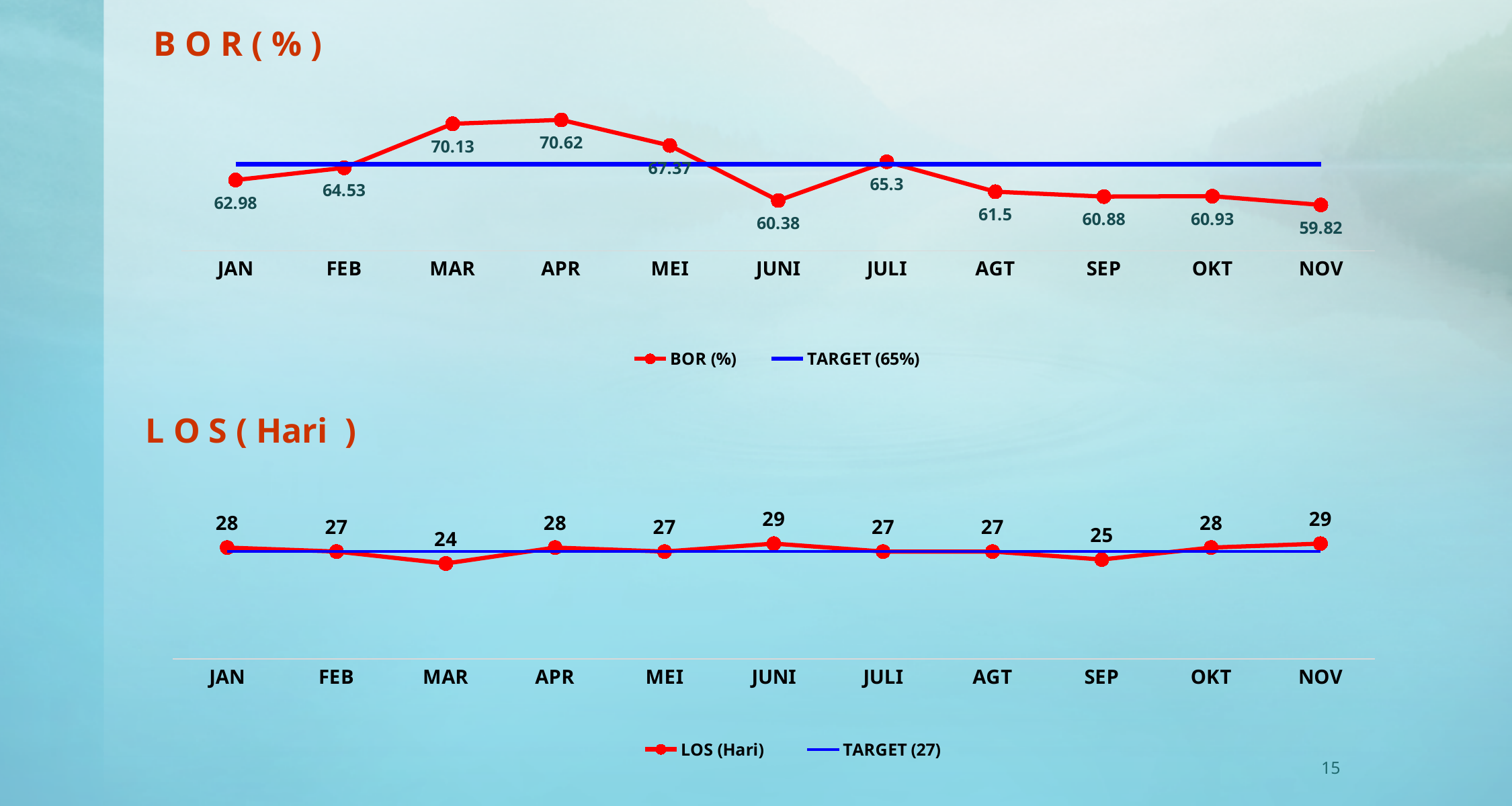
In the BOR (%) chart, which month has the highest BOR value? APR What kind of chart is the LOS (Hari) chart? Line chart In the BOR (%) chart, which month has the lowest BOR value? NOV In the BOR (%) chart, what is the BOR value for APR? 70.62 In the BOR (%) chart, what is the difference between the BOR values for MAR and JUNI? 9.75 In the LOS (Hari) chart, what target value is named in the legend? TARGET (27) In the BOR (%) chart, what is the BOR value for NOV? 59.82 In the BOR (%) chart, how many series does the legend list? 2 In the LOS (Hari) chart, how many months are plotted on the x axis? 11 In the BOR (%) chart, which is larger, the BOR value for JAN or for FEB? FEB In the LOS (Hari) chart, which month has the lowest LOS value? MAR In the LOS (Hari) chart, what is the LOS value for MAR? 24